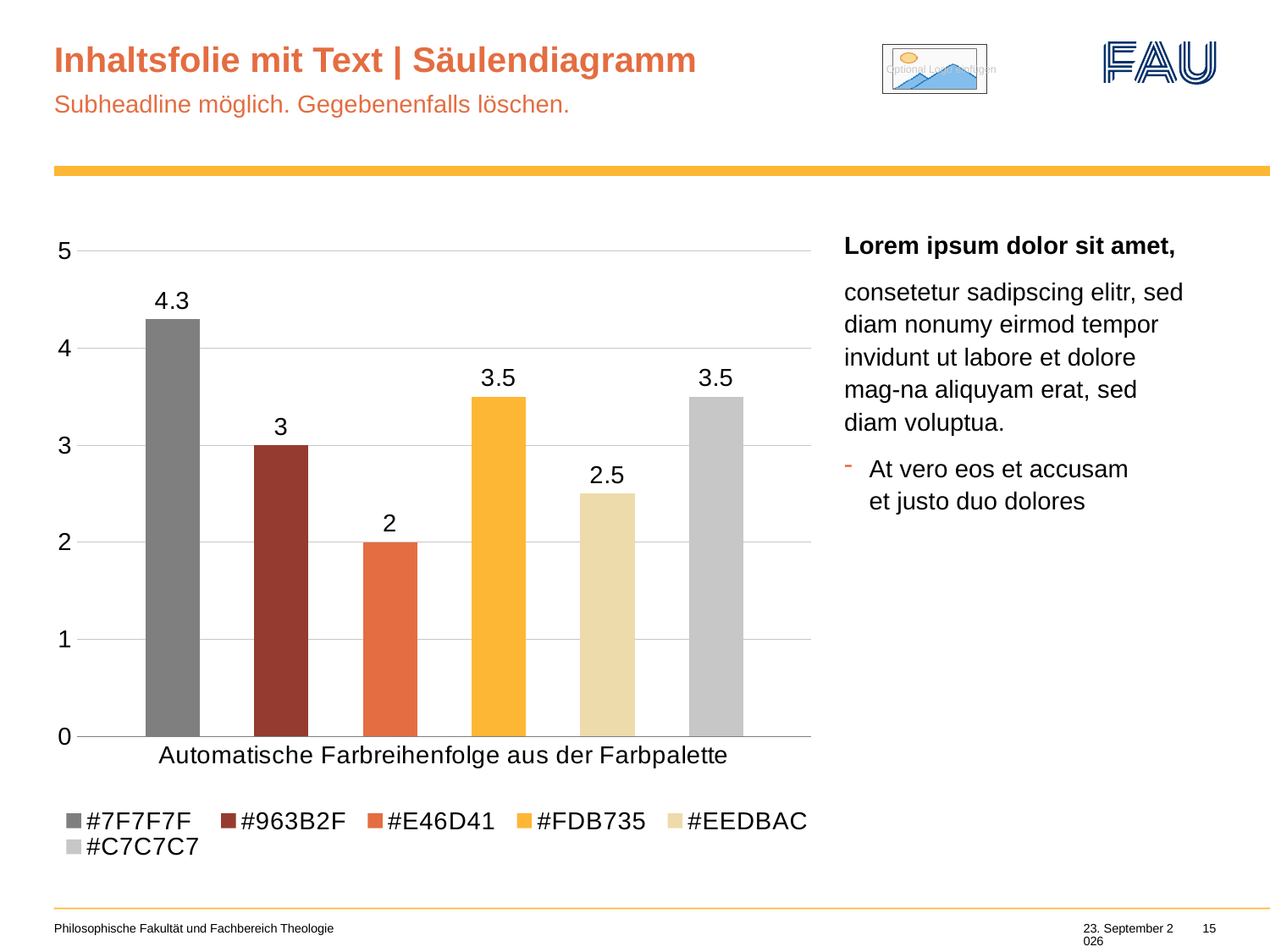
What is the value of the #963B2F series? 3 Is the value for #C7C7C7 greater or less than 3? greater Which is larger, the value for #FDB735 or the value for #EEDBAC? #FDB735 Which series has the lowest value? #E46D41 What is the difference between the #7F7F7F value and the #963B2F value? 1.3 What is the category label shown on the x axis of the chart? Automatische Farbreihenfolge aus der Farbpalette What is the value of the #EEDBAC series? 2.5 What is the value of the #E46D41 series? 2 Which series has the highest value? #7F7F7F How many series does the legend list? 6 What is the value of the #7F7F7F series? 4.3 What kind of chart is shown on the slide? bar chart